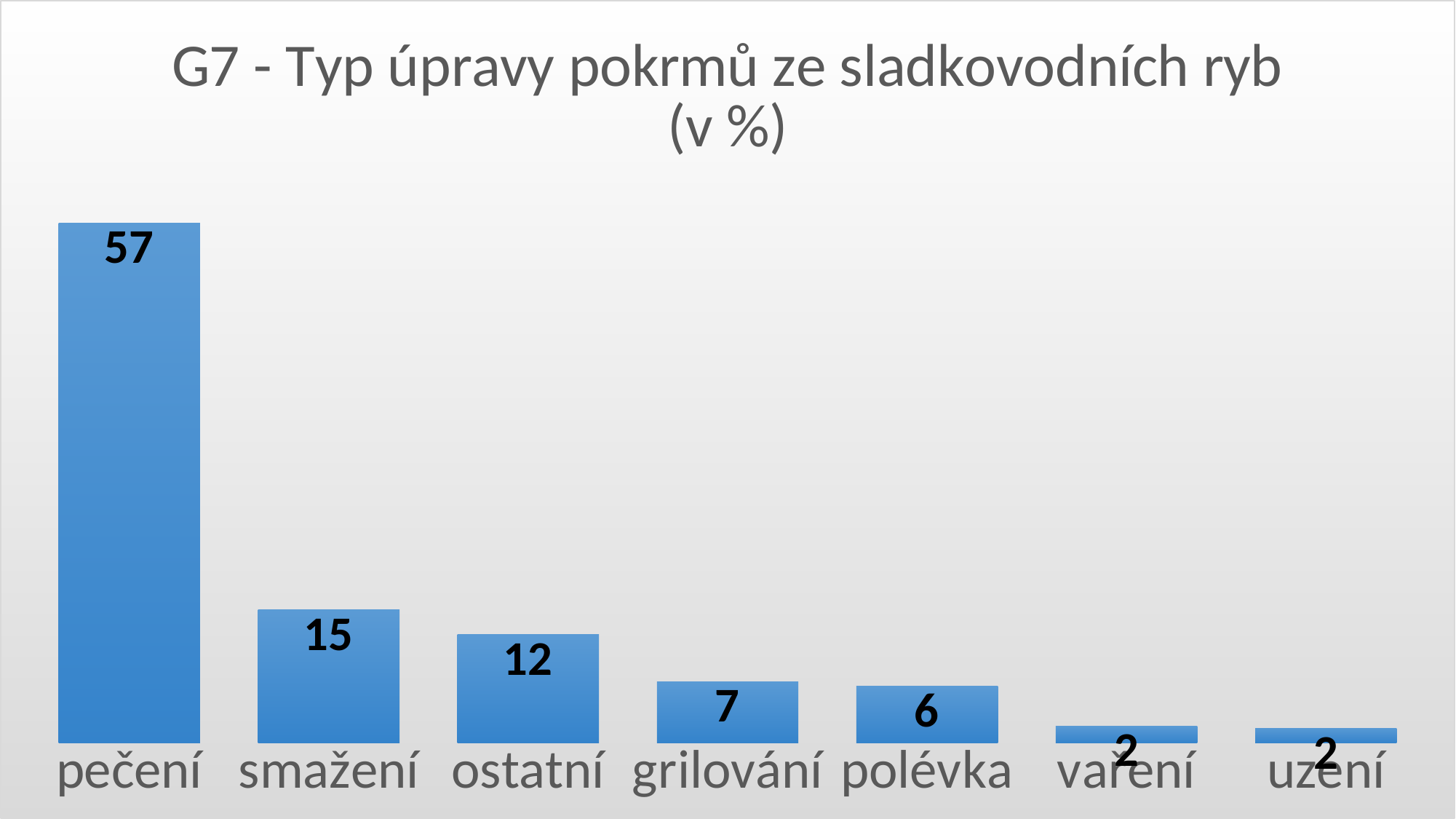
What is the value for smažení? 15 What is the value for grilování? 7 Do the values rise or fall from left to right along the x axis? fall How many categories are shown on the x axis? 7 What is the title of the chart? G7 - Typ úpravy pokrmů ze sladkovodních ryb (v %) Which is larger, the value for smažení or the value for ostatní? smažení What is the value for polévka? 6 What is the value for pečení? 57 Which category has the highest value? pečení What kind of chart is shown on the slide? bar chart What is the difference between the values for pečení and smažení? 42 What is the difference between the values for ostatní and grilování? 5